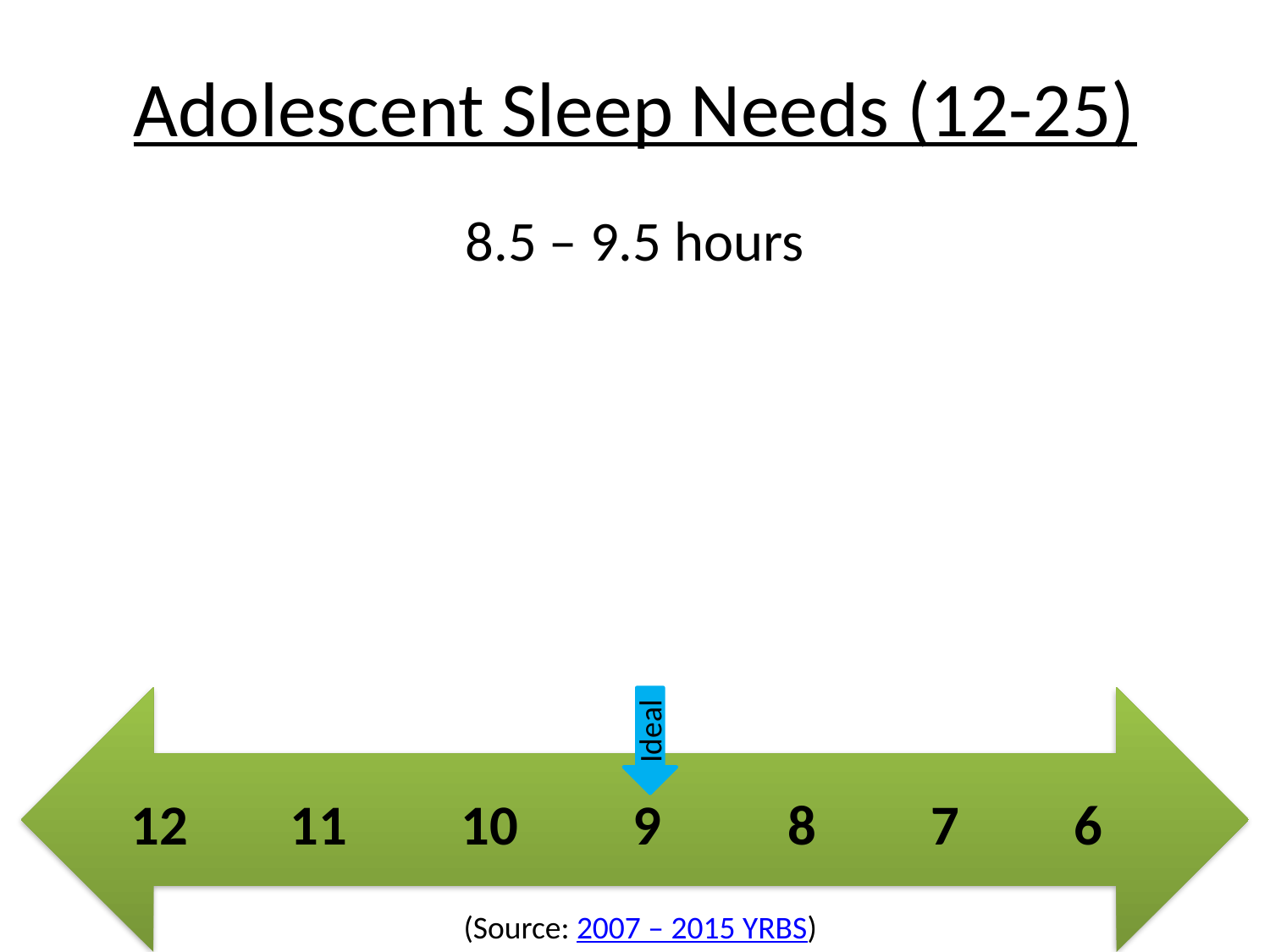
What is the title of the slide? Adolescent Sleep Needs (12-25) What is the largest number shown on the green arrow scale? 12 How many numbers are labeled along the green arrow scale? 7 What is the smallest number shown on the green arrow scale? 6 Do the numbers on the green arrow scale increase or decrease from left to right? decrease What number on the green arrow scale does the blue 'Ideal' marker point to? 9 What range of hours is stated below the title? 8.5 – 9.5 hours